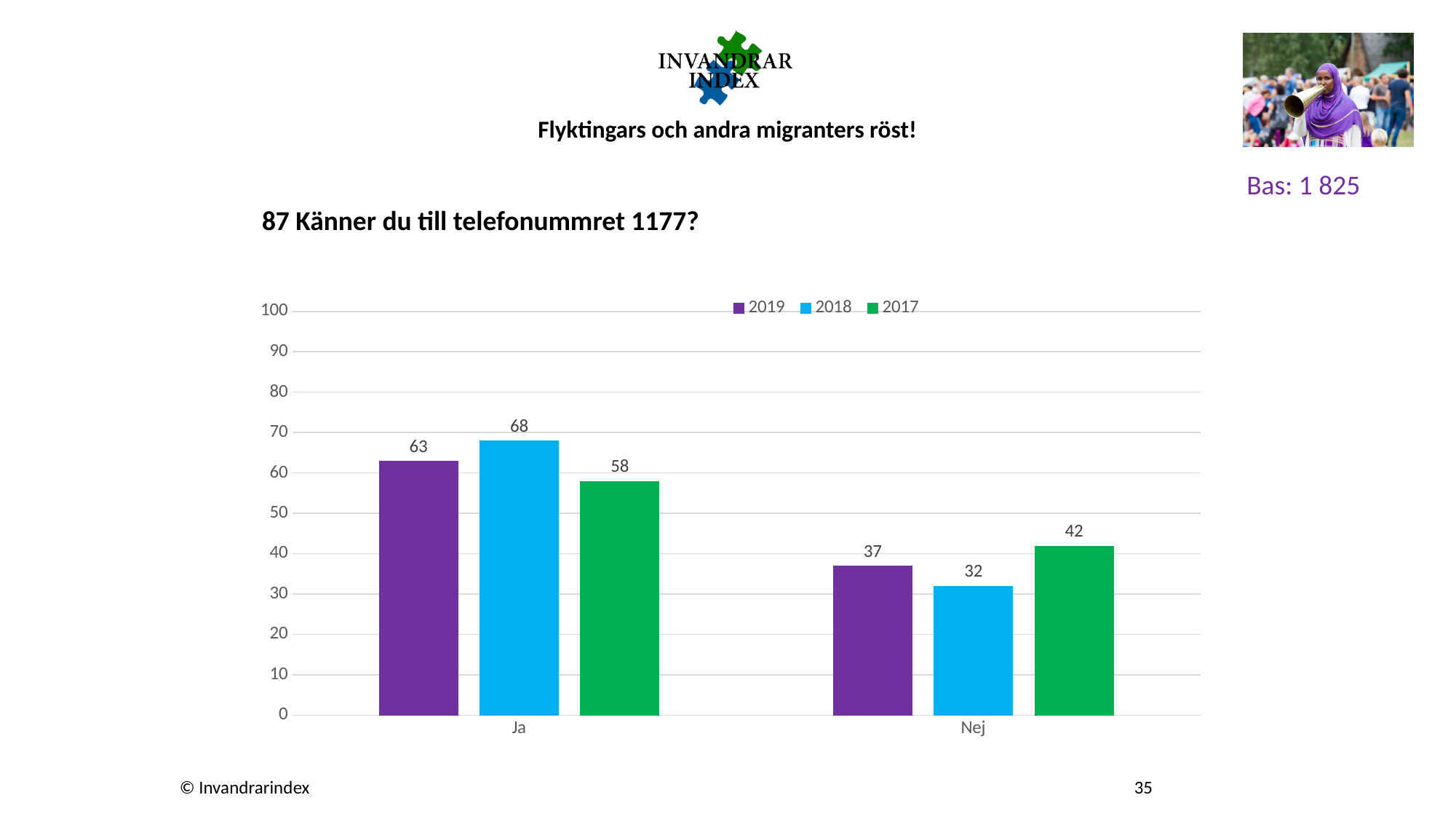
What is the value for 2019 in the Ja category? 63 What is the title of the chart? 87 Känner du till telefonummret 1177? Which year has the lowest value in the Nej category? 2018 Is the value for 2019 in the Nej category greater or less than 40? less How many series does the legend list? 3 What is the difference between the 2018 and 2017 values in the Ja category? 10 How many categories are shown on the x axis? 2 Which year has the highest value in the Ja category? 2018 What is the value for 2018 in the Nej category? 32 What kind of chart is shown on the slide? bar chart What is the value for 2017 in the Ja category? 58 Which is larger: the 2019 value for Nej or the 2017 value for Nej? 2017